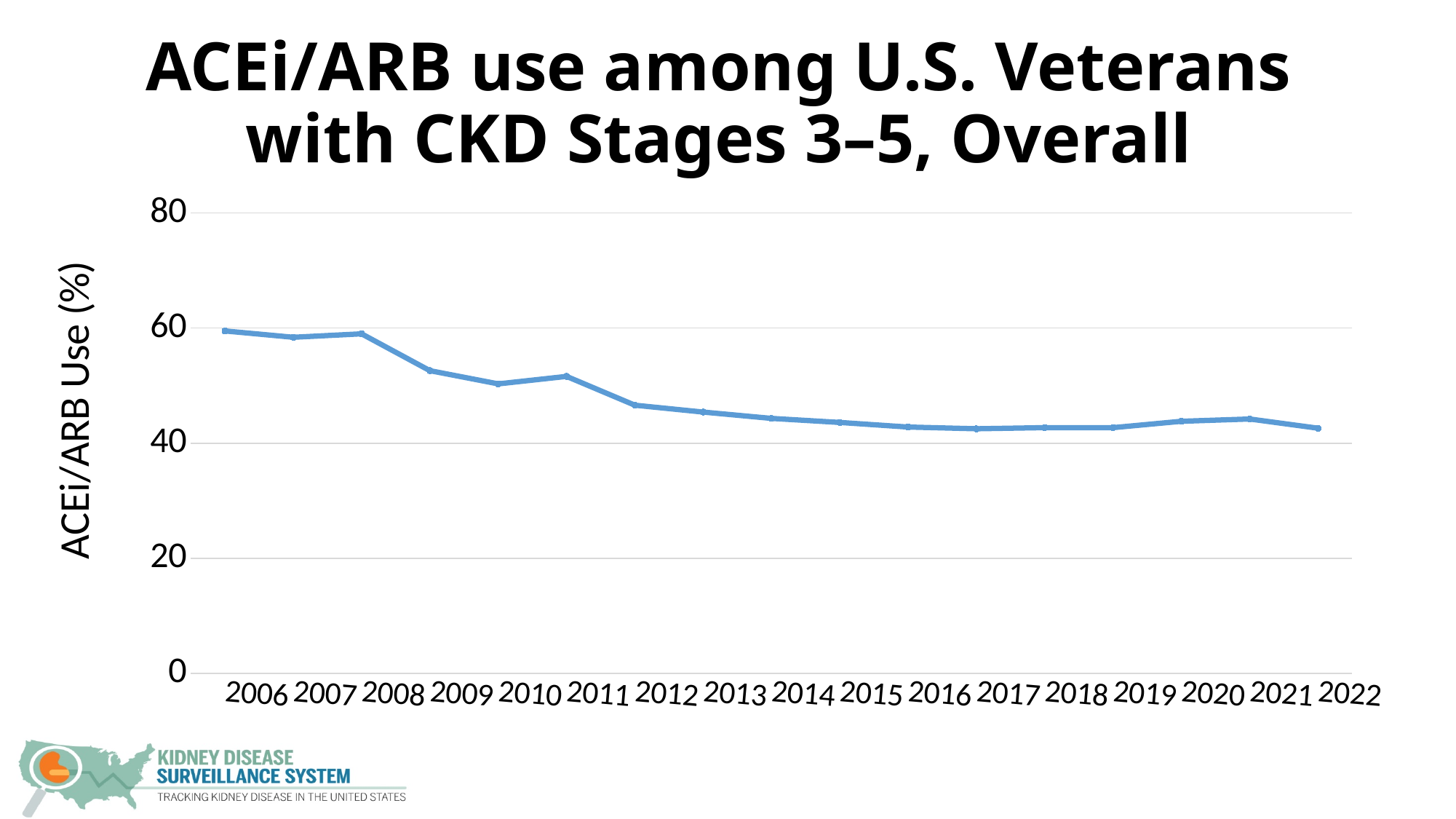
Which year has the higher ACEi/ARB use, 2006 or 2022? 2006 Is the value for 2009 greater or less than 60? less Which year has the higher ACEi/ARB use, 2009 or 2012? 2009 Is the value for 2022 greater or less than 40? greater What is the label on the vertical axis of the chart? ACEi/ARB Use (%) How many years are plotted along the x axis of the chart? 17 Is the value for 2009 greater or less than 40? greater What is the title of the chart? ACEi/ARB use among U.S. Veterans with CKD Stages 3–5, Overall Overall, does ACEi/ARB use rise or fall from 2006 to 2022? fall What kind of chart is shown on the slide? line chart